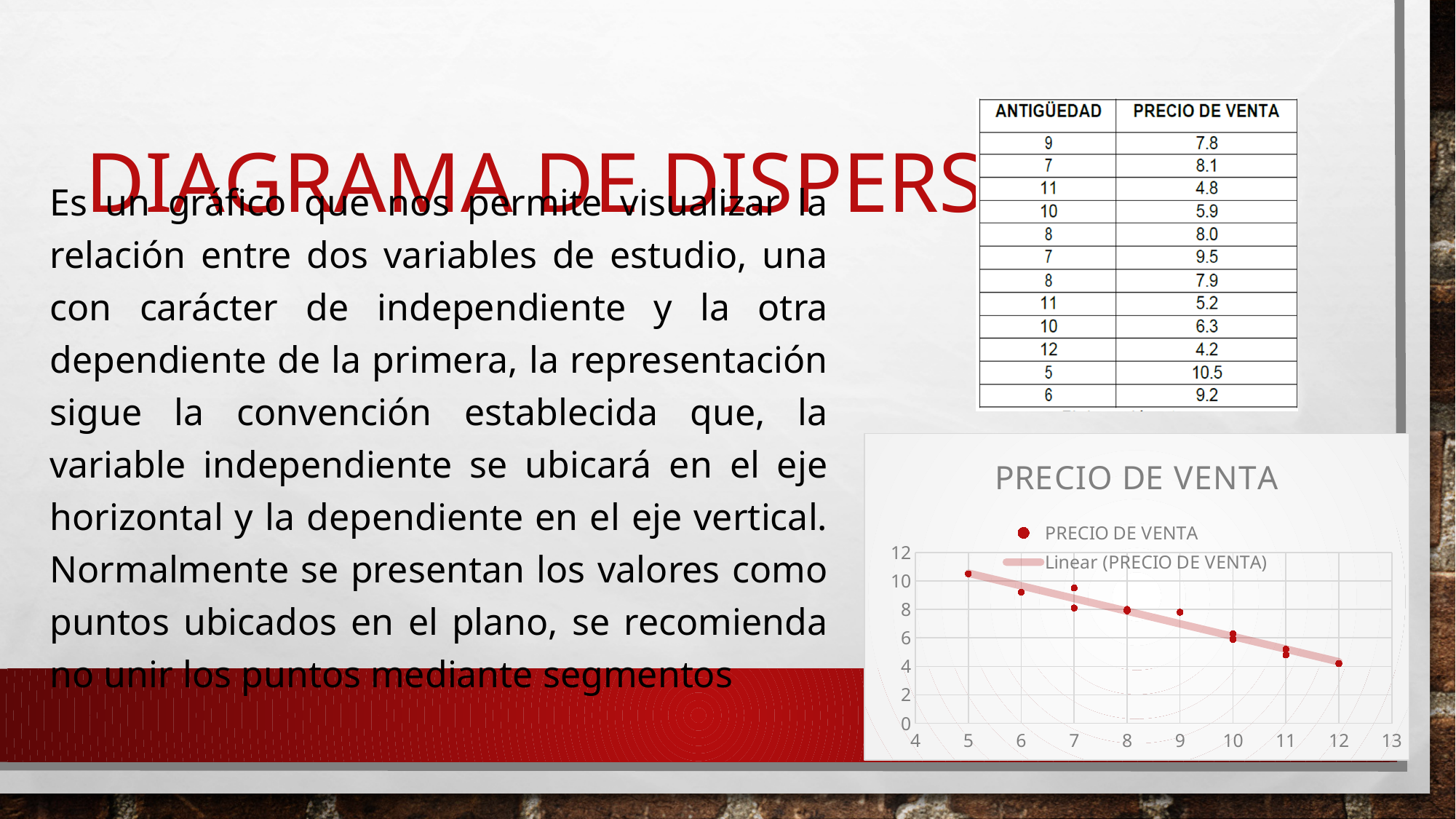
How many data points are plotted in the chart? 12 What is the PRECIO DE VENTA for an ANTIGÜEDAD of 12? 4.2 What is the difference between the highest PRECIO DE VENTA (at ANTIGÜEDAD 5) and the lowest (at ANTIGÜEDAD 12)? 6.3 What kind of chart is shown on the slide? scatter chart At which ANTIGÜEDAD value is the PRECIO DE VENTA highest? 5 What is the PRECIO DE VENTA for an ANTIGÜEDAD of 5? 10.5 Is the PRECIO DE VENTA for an ANTIGÜEDAD of 12 greater or less than 6? less At which ANTIGÜEDAD value is the PRECIO DE VENTA lowest? 12 What is the PRECIO DE VENTA for an ANTIGÜEDAD of 6? 9.2 Do the PRECIO DE VENTA values rise or fall as ANTIGÜEDAD increases along the x axis? fall What is the title of the chart? PRECIO DE VENTA How many entries does the chart legend list? 2